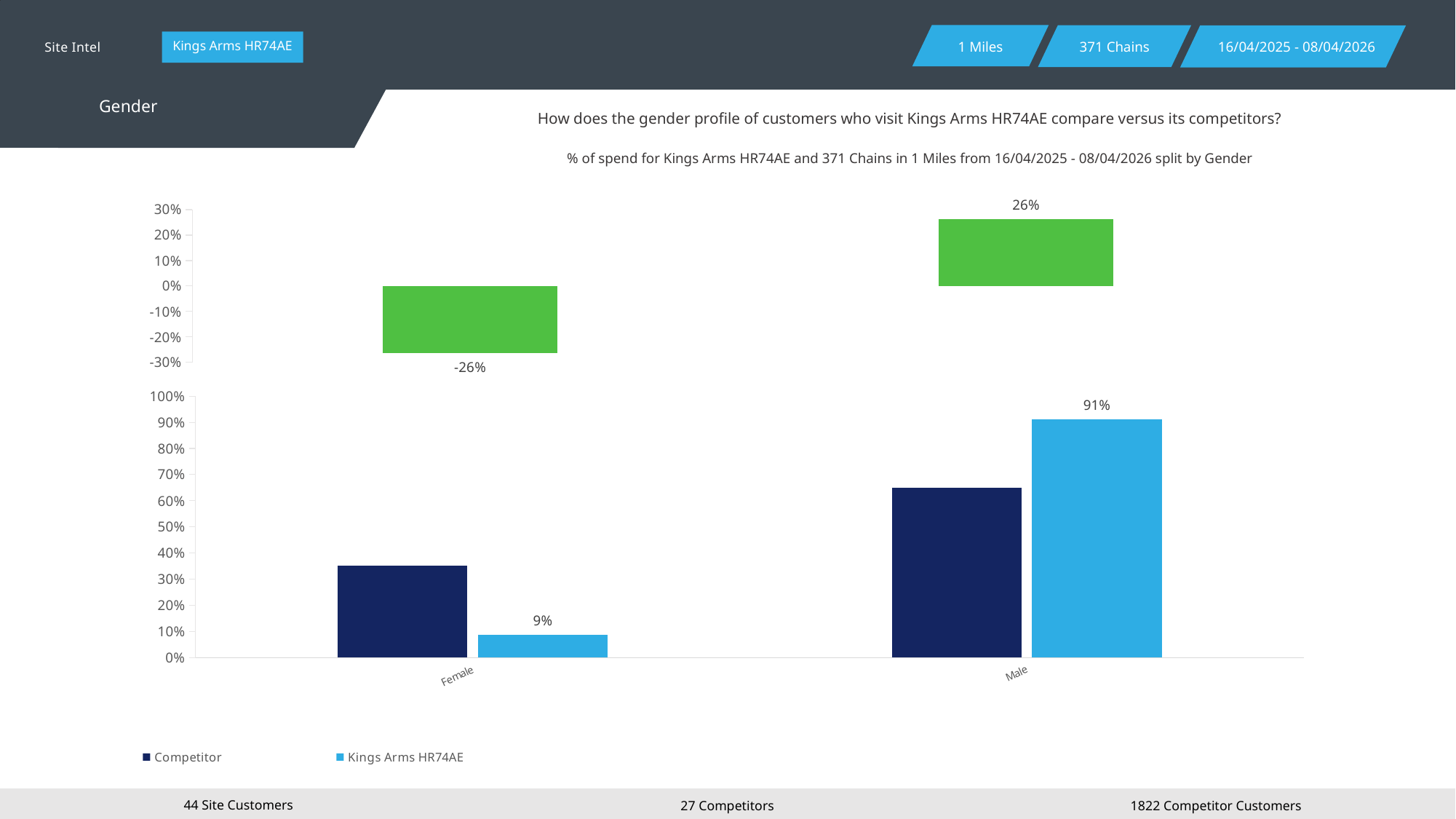
How many categories are shown on the x axis of the bottom chart? 2 In the bottom chart, is the Competitor value for Male greater or less than 70%? less In the bottom chart, which is larger for Male: Competitor or Kings Arms HR74AE? Kings Arms HR74AE What kind of chart is the bottom chart? Bar chart In the top chart, what is the value shown for Female? -26% In the bottom chart, what is the value for Kings Arms HR74AE for Female? 9% In the bottom chart, what is the difference between the Kings Arms HR74AE values for Male and Female? 82% In the bottom chart, which is larger for Female: Competitor or Kings Arms HR74AE? Competitor In the bottom chart, is the Competitor value for Female greater or less than 30%? greater How many series does the legend of the bottom chart list? 2 In the bottom chart, what is the value for Kings Arms HR74AE for Male? 91% In the top chart, what is the value shown for Male? 26%